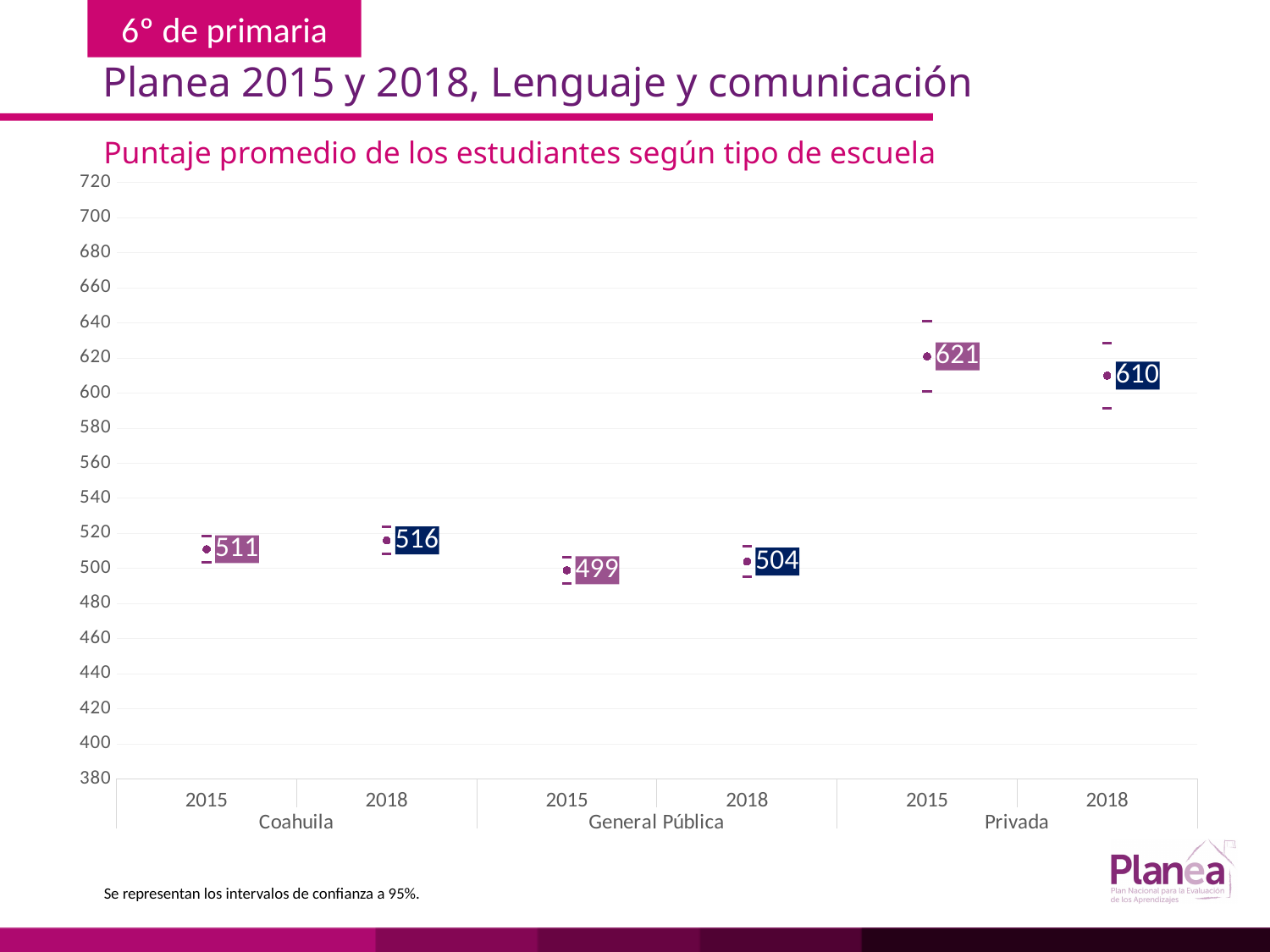
What is the difference between the Coahuila score in 2018 and the General Pública score in 2018? 12 Which school type and year has the lowest average score? General Pública 2015 What is the difference between the Privada scores in 2015 and 2018? 11 What is the average score for Coahuila in 2018? 516 What is the average score for Coahuila in 2015? 511 What is the title of the chart? Puntaje promedio de los estudiantes según tipo de escuela How many data points are plotted on the chart? 6 Did the Privada score rise or fall from 2015 to 2018? Fall What is the average score for General Pública in 2015? 499 What is the average score for Privada in 2018? 610 Which is larger, the Coahuila score in 2015 or the General Pública score in 2018? Coahuila 2015 Which school type and year has the highest average score? Privada 2015